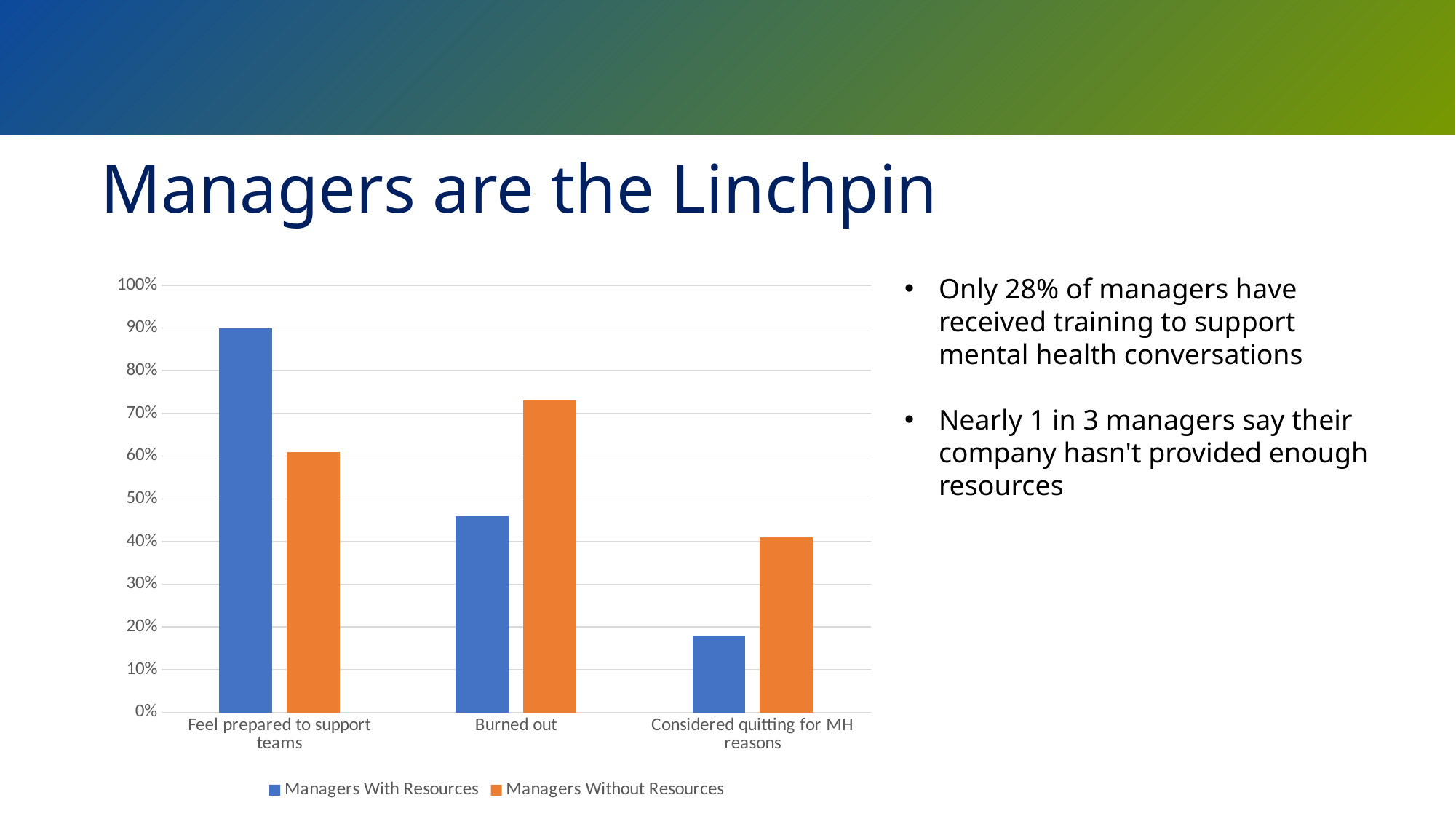
Is the value for Managers With Resources in the Burned out category greater or less than 50%? less For the Feel prepared to support teams category, which series has the larger value: Managers With Resources or Managers Without Resources? Managers With Resources Which category has the lowest value for Managers With Resources? Considered quitting for MH reasons How many categories are shown on the x axis of the chart? 3 Which category has the highest value for Managers Without Resources? Burned out Is the value for Managers Without Resources in the Burned out category greater or less than 70%? greater For the Burned out category, which series has the larger value: Managers With Resources or Managers Without Resources? Managers Without Resources How many series does the chart's legend list? 2 What kind of chart is shown on the slide? Bar chart What colour represents the Managers Without Resources series in the chart? Orange Which category has the highest value for Managers With Resources? Feel prepared to support teams Is the value for Managers With Resources in the Considered quitting for MH reasons category greater or less than 20%? less